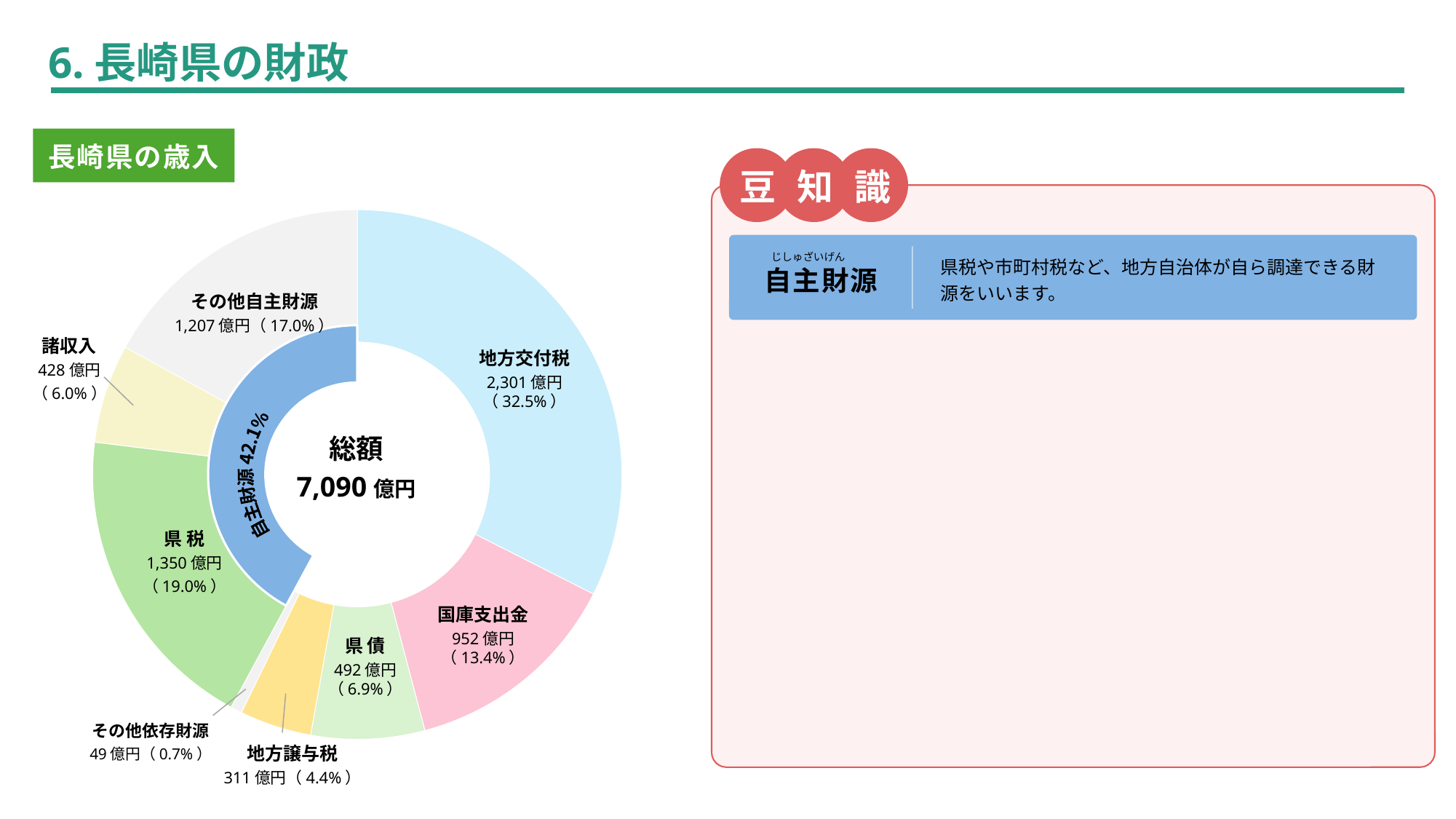
What share of the total does 自主財源 represent according to the inner ring of the 長崎県の歳入 chart? 42.1% What is the value for 地方譲与税 in the 長崎県の歳入 chart? 311 億円 What is the total amount shown in the centre of the 長崎県の歳入 chart? 7,090 億円 Which is larger in the 長崎県の歳入 chart, 県債 or 諸収入? 県債 What share of the total does 県税 represent in the 長崎県の歳入 chart? 19.0% What is the difference between 県税 and その他自主財源 in the 長崎県の歳入 chart? 143 億円 Which category is the largest in the 長崎県の歳入 chart? 地方交付税 What type of chart is shown on the slide? doughnut chart What is the value for 地方交付税 in the 長崎県の歳入 chart? 2,301 億円 What is the value for 国庫支出金 in the 長崎県の歳入 chart? 952 億円 How many categories are shown in the 長崎県の歳入 chart? 8 Which category is the smallest in the 長崎県の歳入 chart? その他依存財源